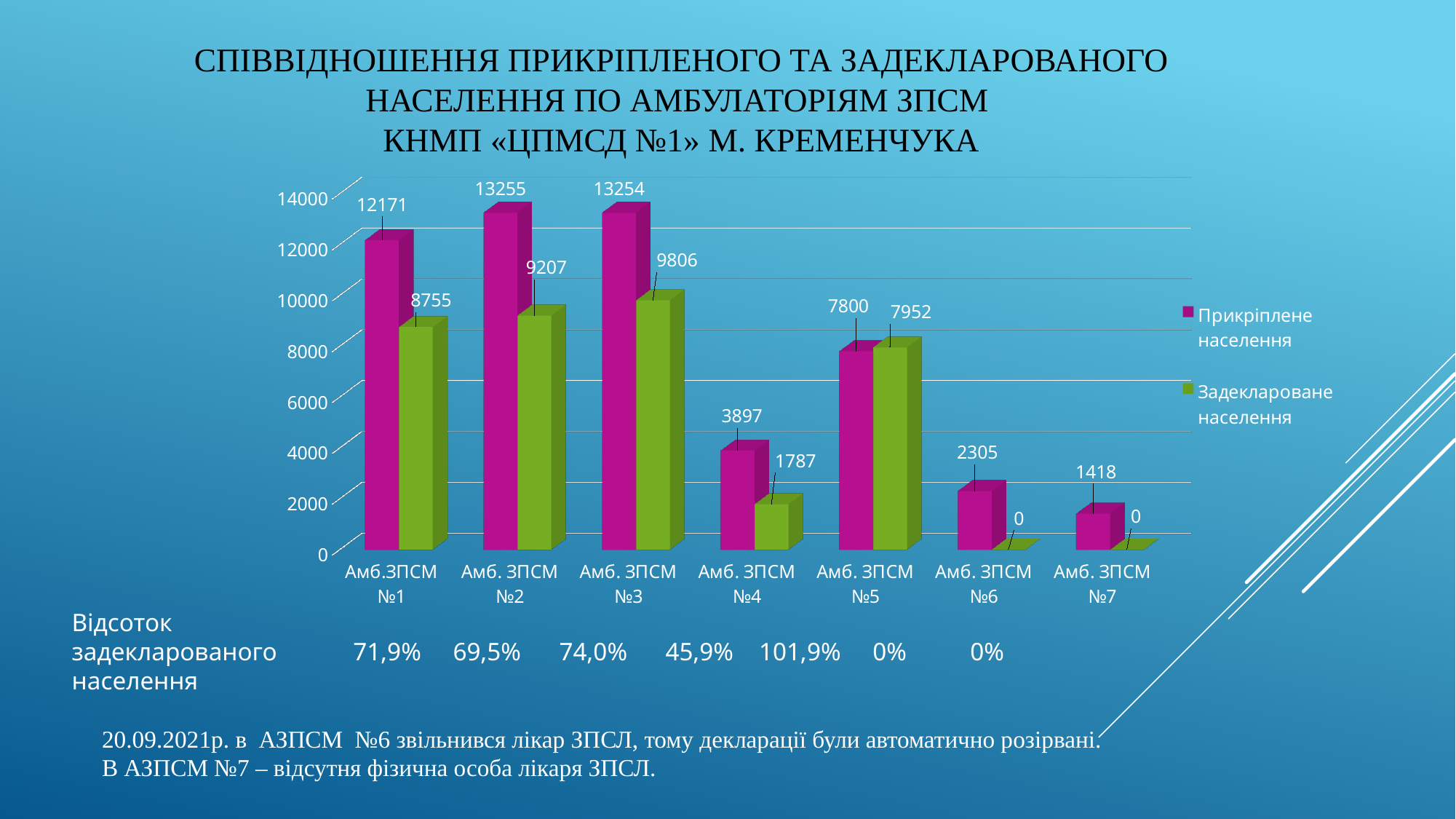
What kind of chart is shown on the slide? bar chart Which category has the highest value for Задеклароване населення? Амб. ЗПСМ №3 For Амб. ЗПСМ №5, which is larger: Прикріплене населення or Задеклароване населення? Задеклароване населення Which category has the lowest value for Прикріплене населення? Амб. ЗПСМ №7 How many series does the legend list? 2 How many categories (амбулаторії) are shown on the x axis? 7 What is the difference between Прикріплене населення and Задеклароване населення for Амб.ЗПСМ №1? 3416 What is the value of Прикріплене населення for Амб. ЗПСМ №2? 13255 What is the value of Задеклароване населення for Амб. ЗПСМ №4? 1787 Is the value of Прикріплене населення for Амб. ЗПСМ №4 greater or less than 4000? less What is the value of Задеклароване населення for Амб. ЗПСМ №6? 0 What colour represents Задеклароване населення in the chart? green